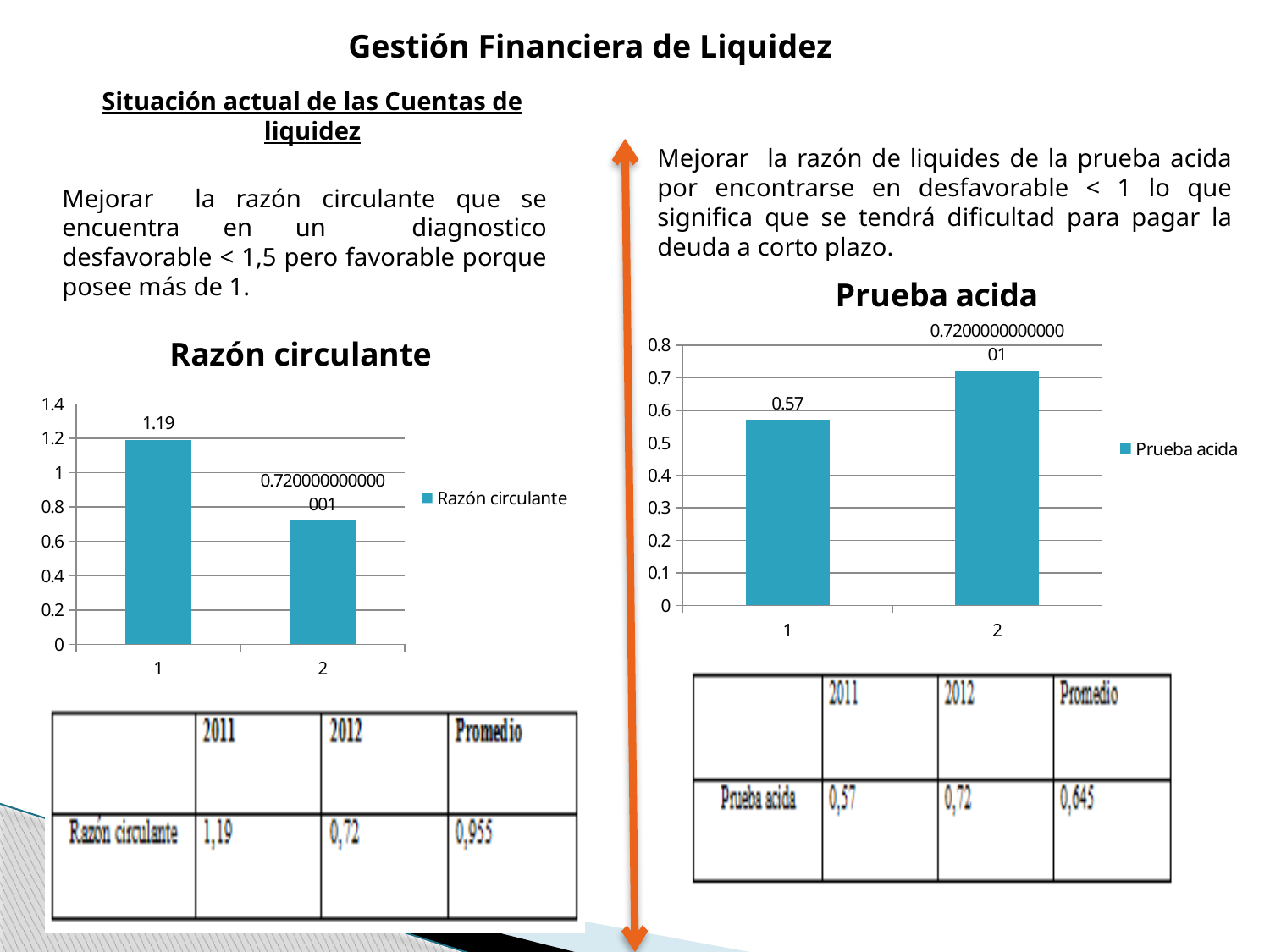
In the Prueba acida chart, which category has the larger value, 1 or 2? 2 What kind of chart is the Prueba acida chart? bar chart In the Razón circulante chart, is the value for category 2 greater or less than 1? less In the Prueba acida chart, which category has the lowest value? 1 In the Razón circulante chart, which category has the highest value? 1 In the Razón circulante chart, what is the value for category 1? 1.19 What is the legend entry shown in the Razón circulante chart? Razón circulante In the Prueba acida chart, what is the value for category 1? 0.57 In the Prueba acida chart, is the value for category 2 greater or less than 0.7? greater In the Razón circulante chart, do the values rise or fall from category 1 to category 2? fall How many series does the legend of the Prueba acida chart list? 1 How many bars are plotted in the Razón circulante chart? 2